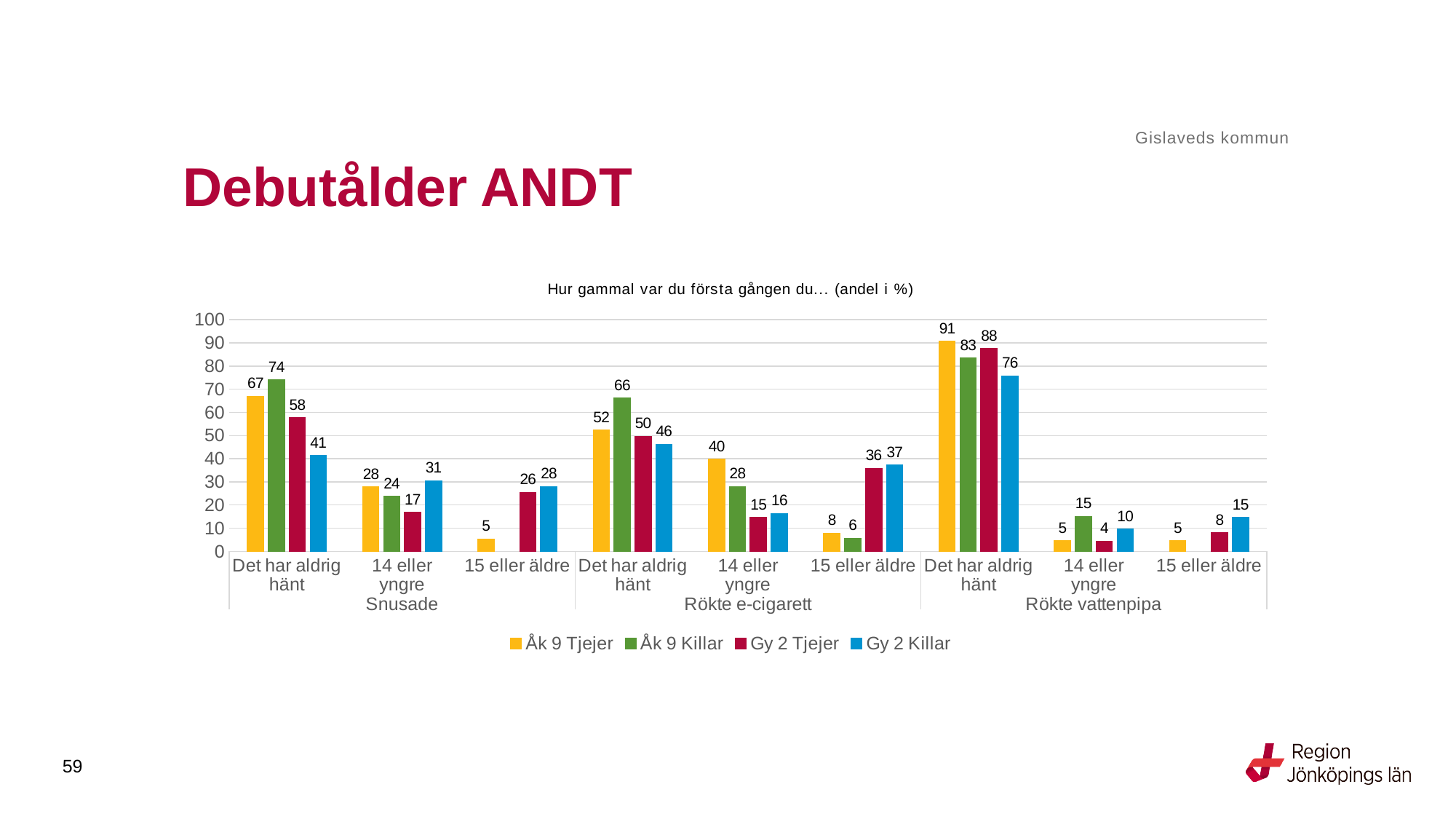
What is the title of the chart? Hur gammal var du första gången du… (andel i %) What is the value for Gy 2 Killar for '14 eller yngre' under Rökte e-cigarett? 16 Which series has the highest value for 'Det har aldrig hänt' under Rökte vattenpipa? Åk 9 Tjejer What is the value for Gy 2 Tjejer for 'Det har aldrig hänt' under Rökte vattenpipa? 88 What is the difference between the Åk 9 Tjejer and Gy 2 Killar values for 'Det har aldrig hänt' under Snusade? 26 What is the value for Åk 9 Killar for 'Det har aldrig hänt' under Snusade? 74 Which series has the lowest value for '14 eller yngre' under Rökte vattenpipa? Gy 2 Tjejer Is the value for Åk 9 Killar for 'Det har aldrig hänt' under Rökte e-cigarett greater or less than 60? greater Which is larger for '15 eller äldre' under Rökte e-cigarett: Åk 9 Tjejer or Gy 2 Tjejer? Gy 2 Tjejer How many series does the legend list? 4 What colour represents Gy 2 Killar in the chart? Blue What kind of chart is shown on the slide? Bar chart